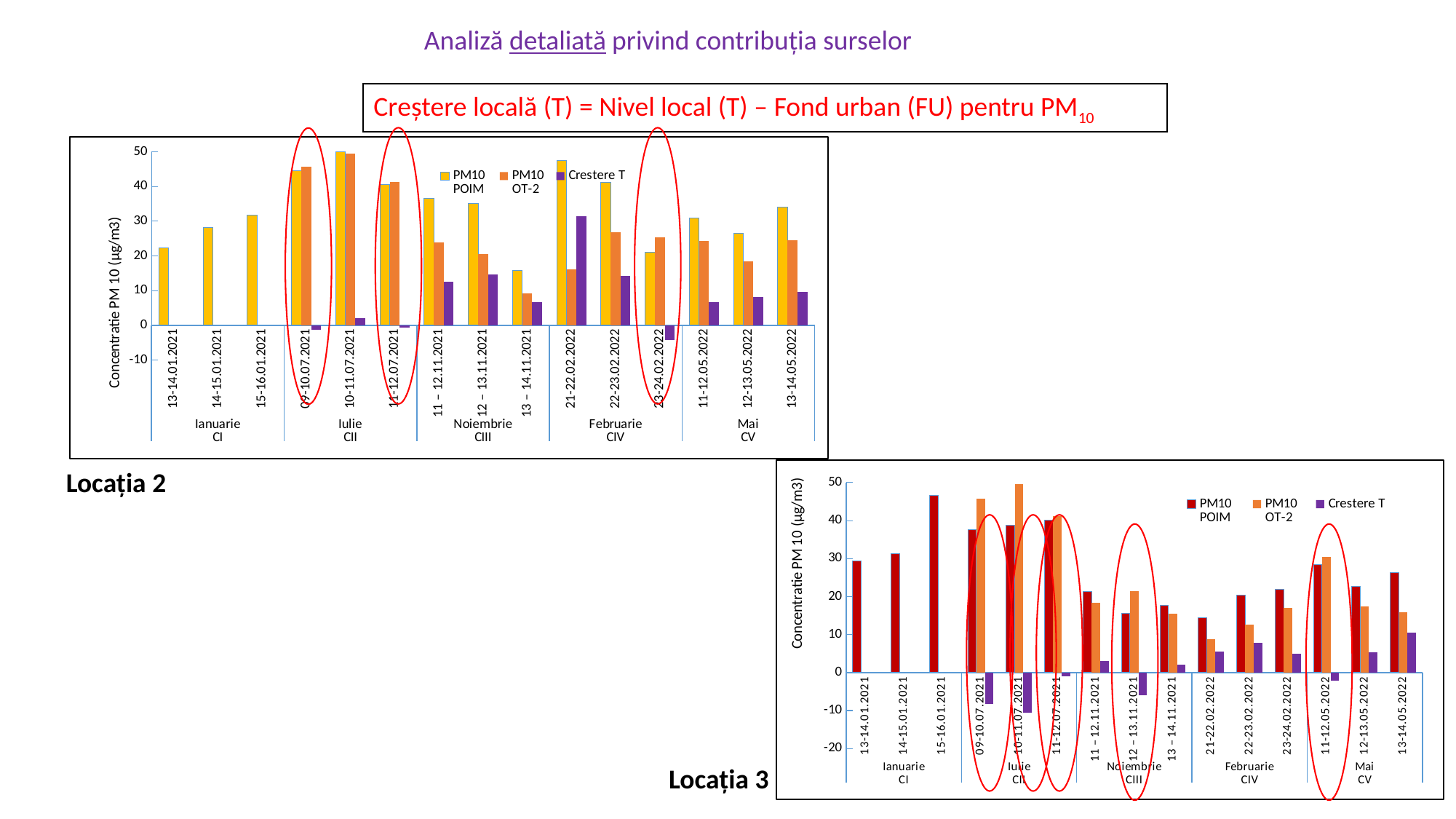
In the Locația 2 chart, do the PM10 POIM values rise or fall across the three Ianuarie dates? rise In the Locația 3 chart, which date has the highest PM10 POIM value? 15-16.01.2021 How many date categories are shown on the x axis of the Locația 2 chart? 15 In the Locația 2 chart, is the PM10 POIM value for 21-22.02.2022 greater or less than 40? greater In the Locația 2 chart, which date has the highest Crestere T value? 21-22.02.2022 In the Locația 3 chart, is the Crestere T value for 10-11.07.2021 greater or less than 0? less In the Locația 2 chart, is the Crestere T value for 21-22.02.2022 greater or less than 20? greater What kind of chart is the Locația 2 chart? bar chart In the Locația 2 chart, for 11 - 12.11.2021, which is larger: PM10 POIM or PM10 OT-2? PM10 POIM How many series does the legend of the Locația 3 chart list? 3 In the Locația 3 chart, for 09-10.07.2021, which is larger: PM10 POIM or PM10 OT-2? PM10 OT-2